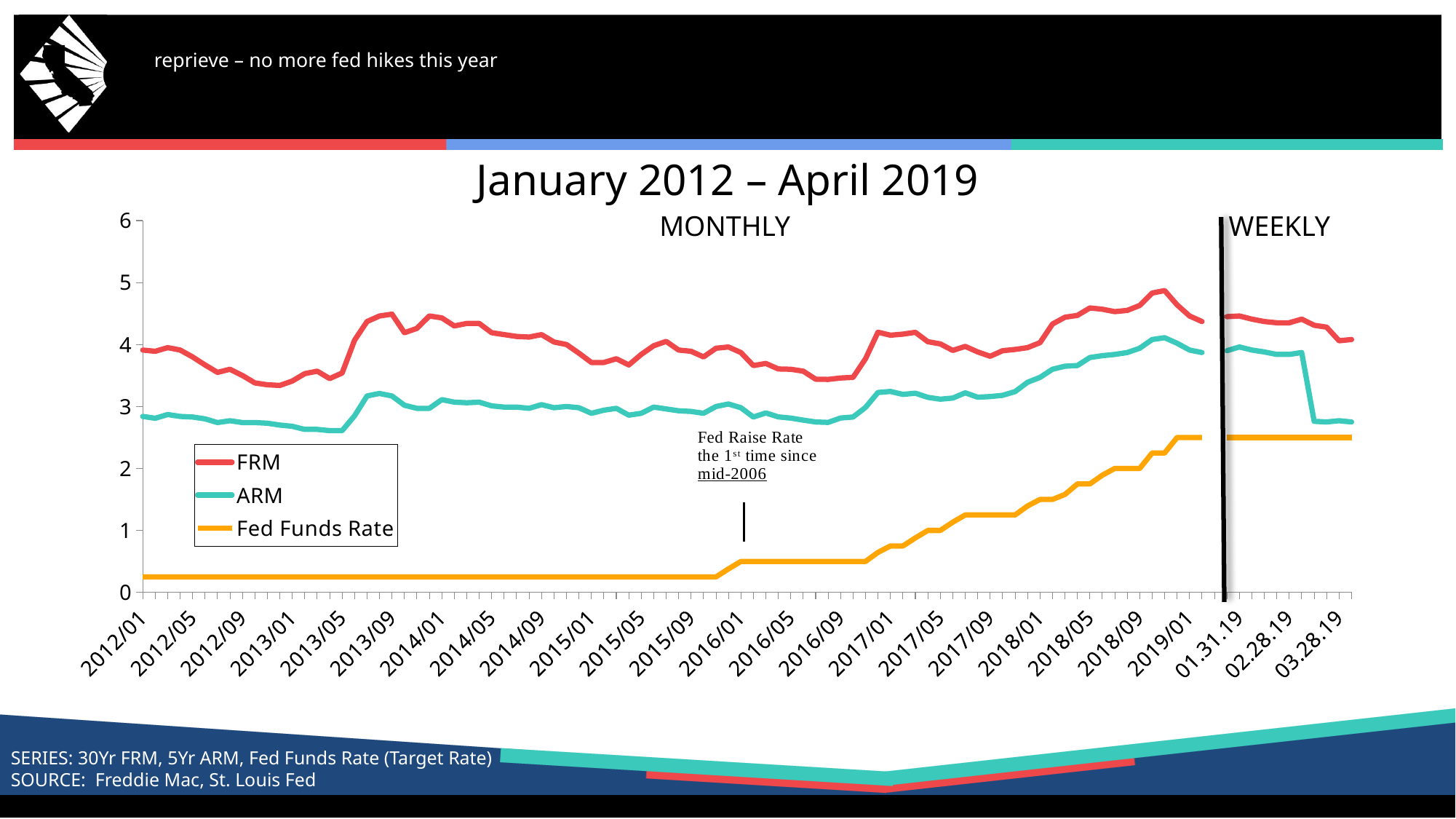
What is the title of the chart? January 2012 – April 2019 Is the FRM value at 2018/09 greater or less than 4? greater Which series has the highest values across the whole chart? FRM Is the ARM value at 2013/01 greater or less than 3? less How many series does the legend list? 3 Is the Fed Funds Rate value at 2012/01 greater or less than 1? less Does the Fed Funds Rate rise or fall between 2016/01 and 2019/01? rise Which series has the lowest values across the whole chart? Fed Funds Rate Which series is drawn in orange according to the legend? Fed Funds Rate Which series has the higher value at 2019/01, FRM or ARM? FRM What kind of chart is shown on the slide? line chart